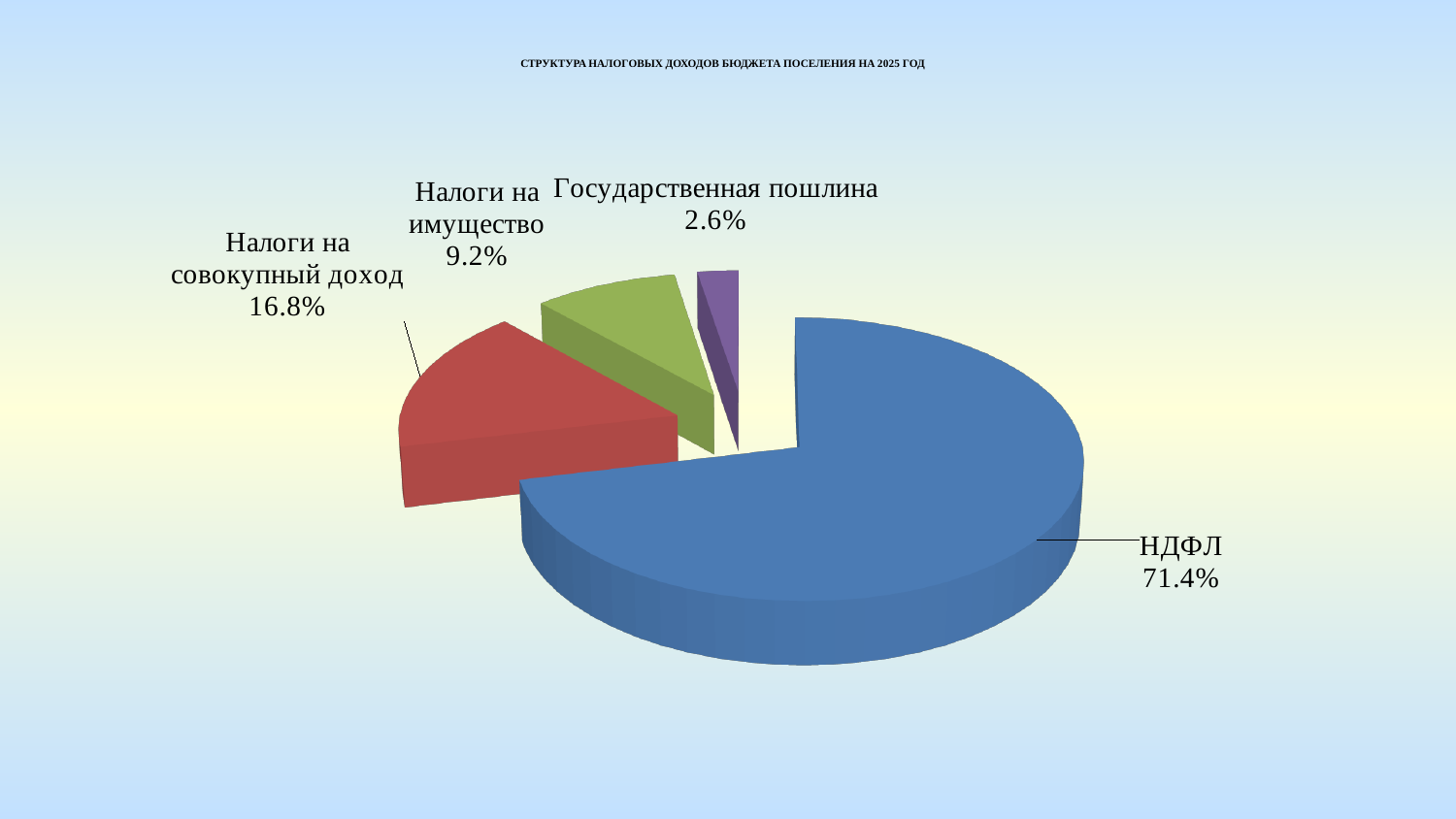
What is the difference between the shares of НДФЛ and Налоги на совокупный доход? 54.6% What kind of chart is shown on the slide? pie chart Which category has the smallest slice of the pie? Государственная пошлина What is the value shown for Налоги на совокупный доход? 16.8% What is the value shown for Государственная пошлина? 2.6% How many slices does the pie chart have? 4 What share of the pie does НДФЛ have? 71.4% Which is larger, the share of Налоги на имущество or the share of Государственная пошлина? Налоги на имущество What colour is the НДФЛ slice? blue Which category has the largest slice of the pie? НДФЛ What is the value shown for Налоги на имущество? 9.2% What is the difference between the shares of Налоги на совокупный доход and Налоги на имущество? 7.6%